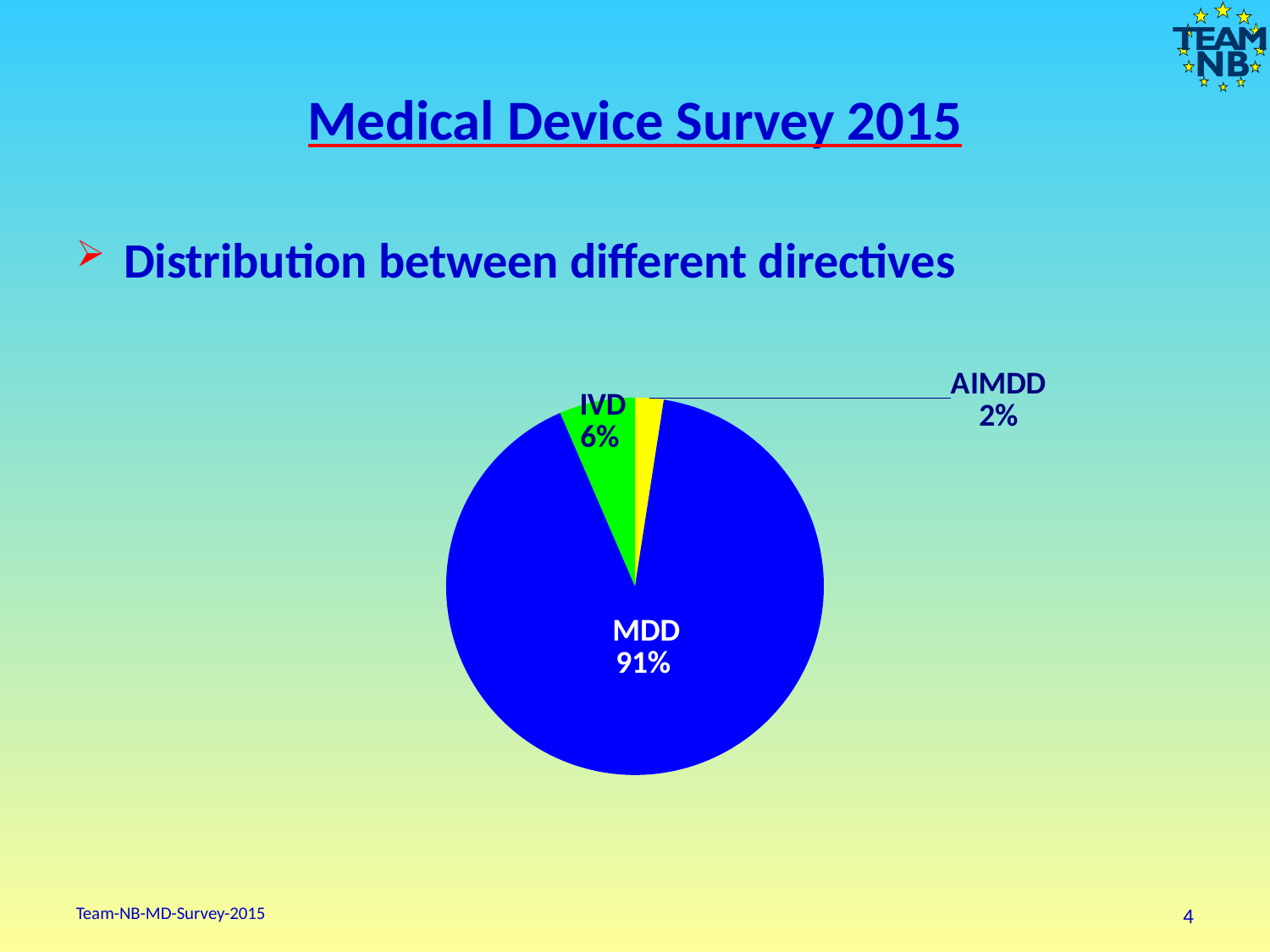
What share of the pie does IVD account for? 6% What share of the pie does MDD account for? 91% How many slices does the pie chart have? 3 What is the difference in percentage points between the IVD and AIMDD slices? 4 What is the difference in percentage points between the MDD and IVD slices? 85 What colour is the IVD slice? green Which directive has the smallest slice of the pie? AIMDD What share of the pie does AIMDD account for? 2% Which directive has the largest slice of the pie? MDD Which slice is larger, IVD or AIMDD? IVD What kind of chart is shown on the slide? pie chart What colour is the MDD slice? blue